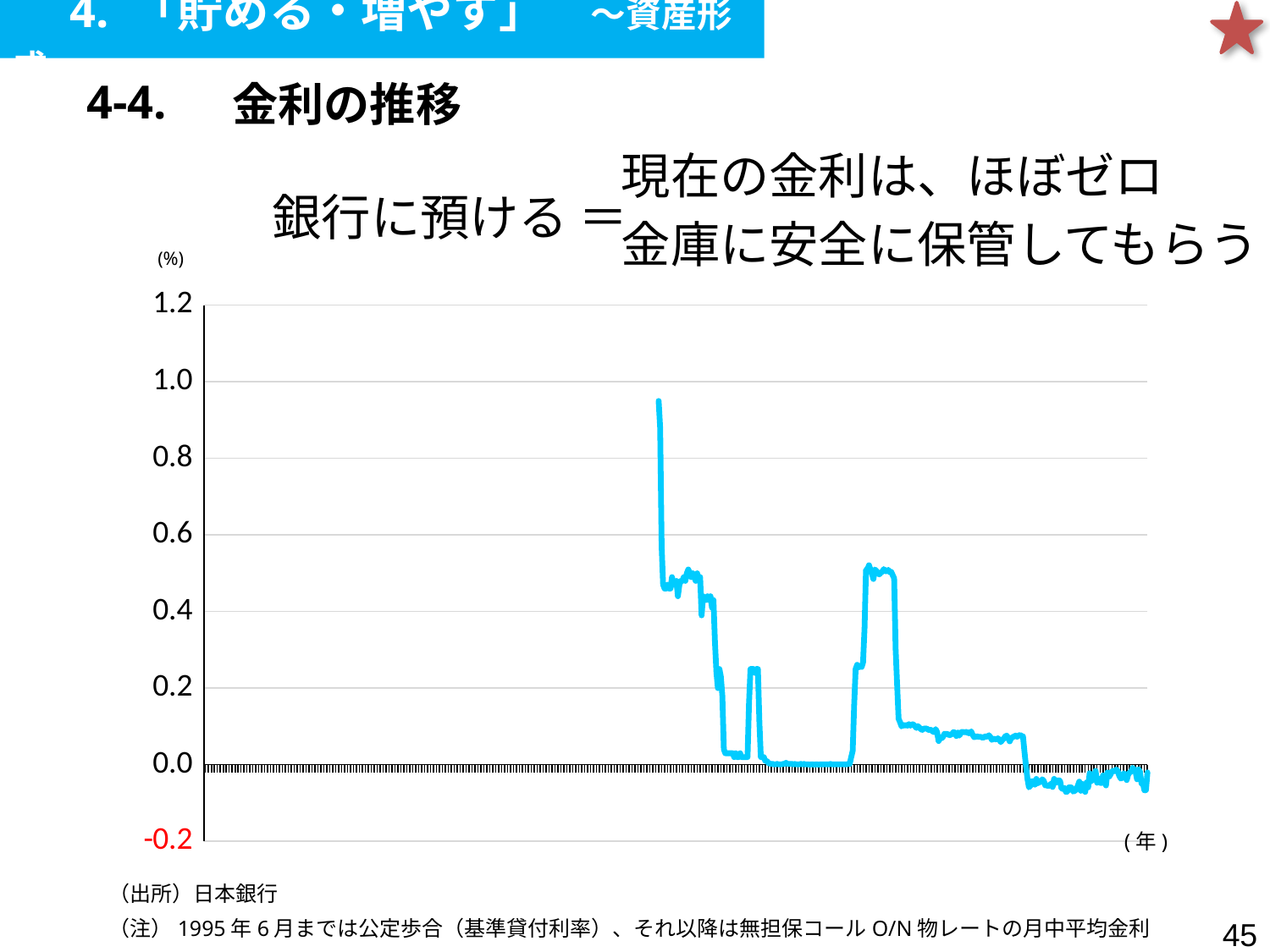
Is the value at the right end of the line greater or less than 0.0? less Is the value at the right end of the line greater or less than 0.2? less Overall, does the plotted interest rate rise or fall from left to right along the x axis? fall Is the highest value reached by the line greater or less than 0.8? greater How many lines are plotted on the chart? 1 What is the highest tick value shown on the vertical axis? 1.2 What unit is indicated for the vertical axis of the chart? % What is the lowest tick value shown on the vertical axis? -0.2 What is the title of the chart section on the slide? 4-4. 金利の推移 What kind of chart is shown on the slide? line chart